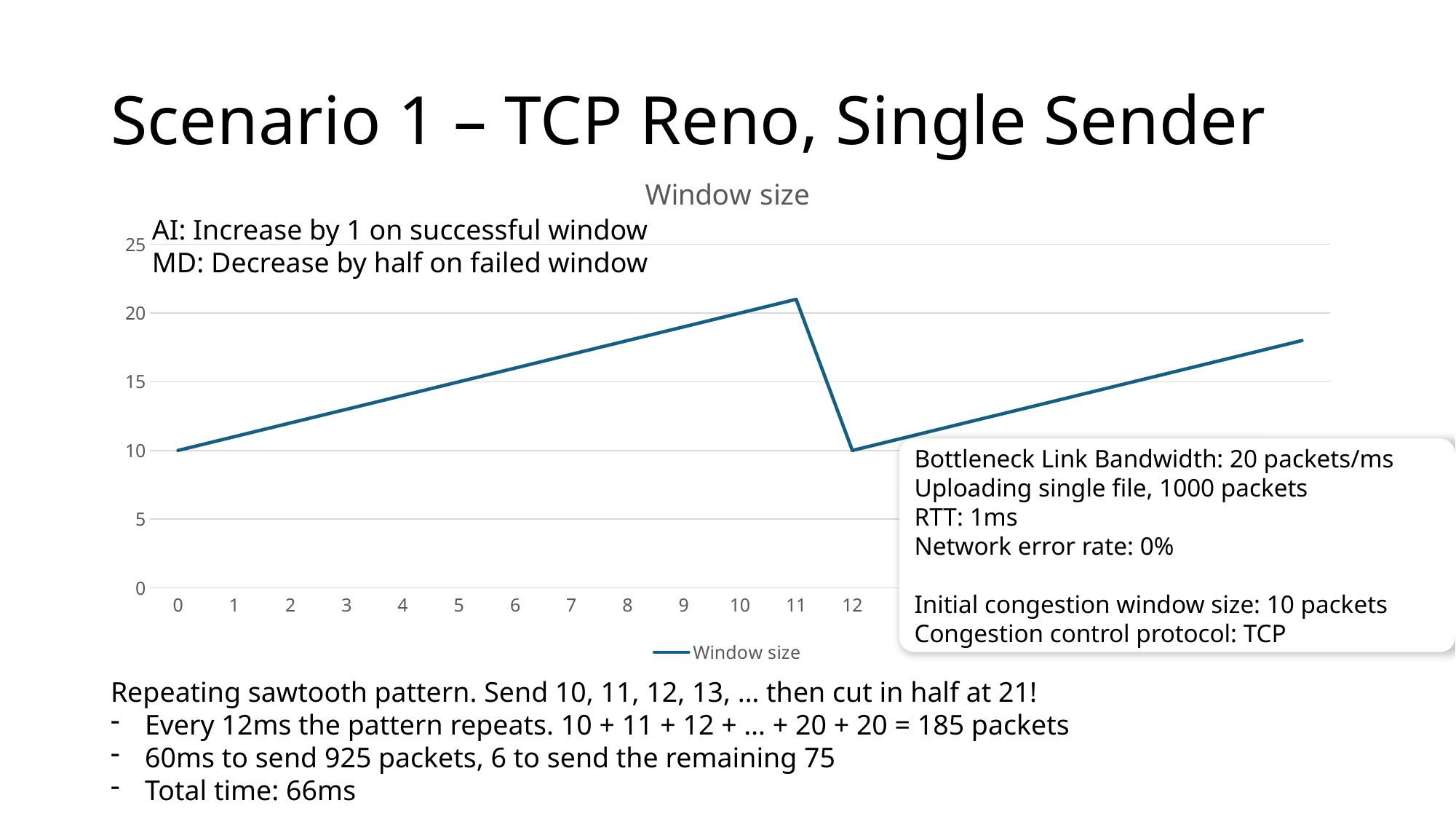
What is the difference between the window size at x = 10 and at x = 0? 10 How many series does the chart legend list? 1 What is the window size at x = 12? 10 Does the window size rise or fall between x = 0 and x = 11? rise What is the window size at x = 5? 15 Is the window size at x = 11 greater or less than 20? greater What kind of chart is shown on the slide? line chart What is the title of the chart? Window size What is the window size at x = 10? 20 What is the window size at x = 0? 10 Which is larger, the window size at x = 11 or at x = 12? x = 11 At which x value does the window size reach its highest point? 11